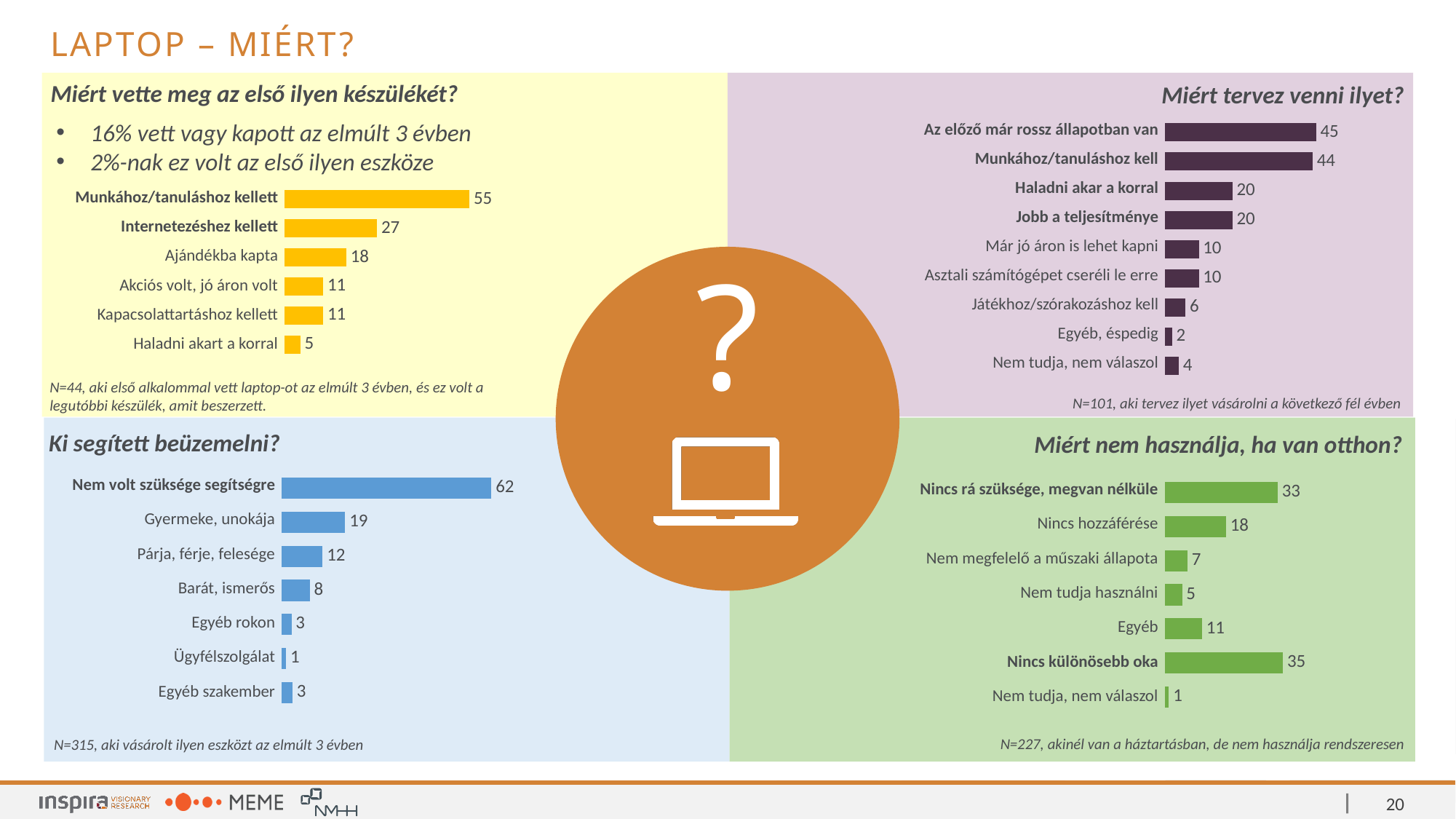
In the chart 'Miért vette meg az első ilyen készülékét?', which category has the highest value? Munkához/tanuláshoz kellett In the chart 'Miért nem használja, ha van otthon?', which category has the highest value? Nincs különösebb oka In the chart 'Miért vette meg az első ilyen készülékét?', what is the value for 'Internetezéshez kellett'? 27 In the chart 'Miért vette meg az első ilyen készülékét?', how many categories are shown? 6 In the chart 'Miért nem használja, ha van otthon?', what is the difference between 'Nincs rá szüksége, megvan nélküle' and 'Nincs hozzáférése'? 15 In the chart 'Ki segített beüzemelni?', which category has the lowest value? Ügyfélszolgálat In the chart 'Miért tervez venni ilyet?', what is the value for 'Haladni akar a korral'? 20 In the chart 'Ki segített beüzemelni?', what is the value for 'Gyermeke, unokája'? 19 What type of chart is 'Miért nem használja, ha van otthon?'? Bar chart In the chart 'Miért tervez venni ilyet?', which category has the lowest value? Egyéb, éspedig In the chart 'Ki segített beüzemelni?', which is larger: 'Párja, férje, felesége' or 'Barát, ismerős'? Párja, férje, felesége In the chart 'Miért tervez venni ilyet?', what is the difference between 'Az előző már rossz állapotban van' and 'Játékhoz/szórakozáshoz kell'? 39